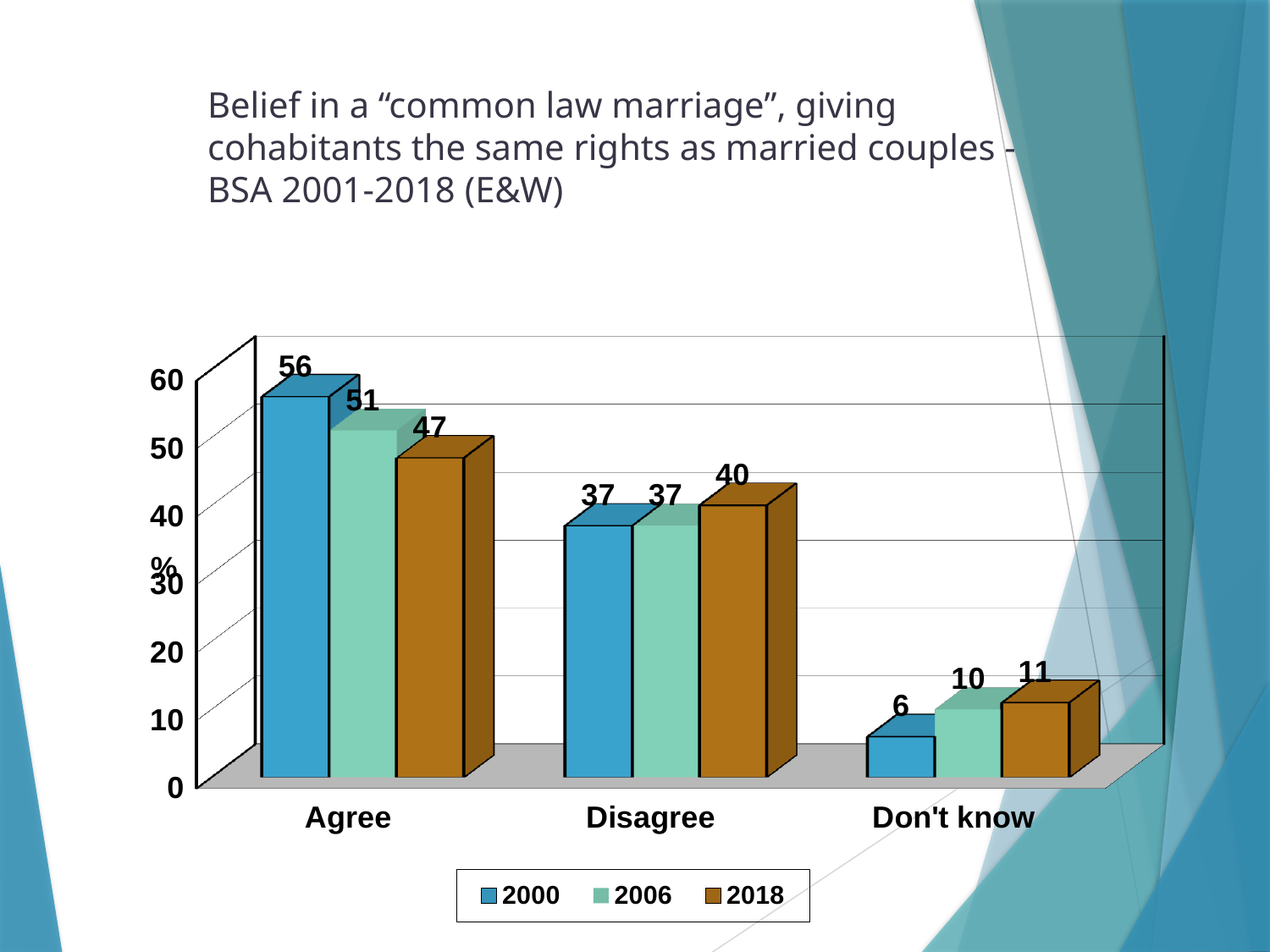
What is the value for Don't know in 2018? 11 What kind of chart is shown on the slide? Bar chart How many categories are shown on the x axis? 3 What is the value for Disagree in 2006? 37 What is the difference between the Agree values for 2000 and 2018? 9 What percentage agreed in 2000? 56 How many series does the legend list? 3 Is the value for Agree in 2006 greater or less than 50? greater Which is larger: Disagree in 2018 or Disagree in 2000? Disagree in 2018 Does the Agree value rise or fall from 2000 to 2018? Fall Which category has the lowest value for the 2000 series? Don't know Which category has the highest value for the 2018 series? Agree